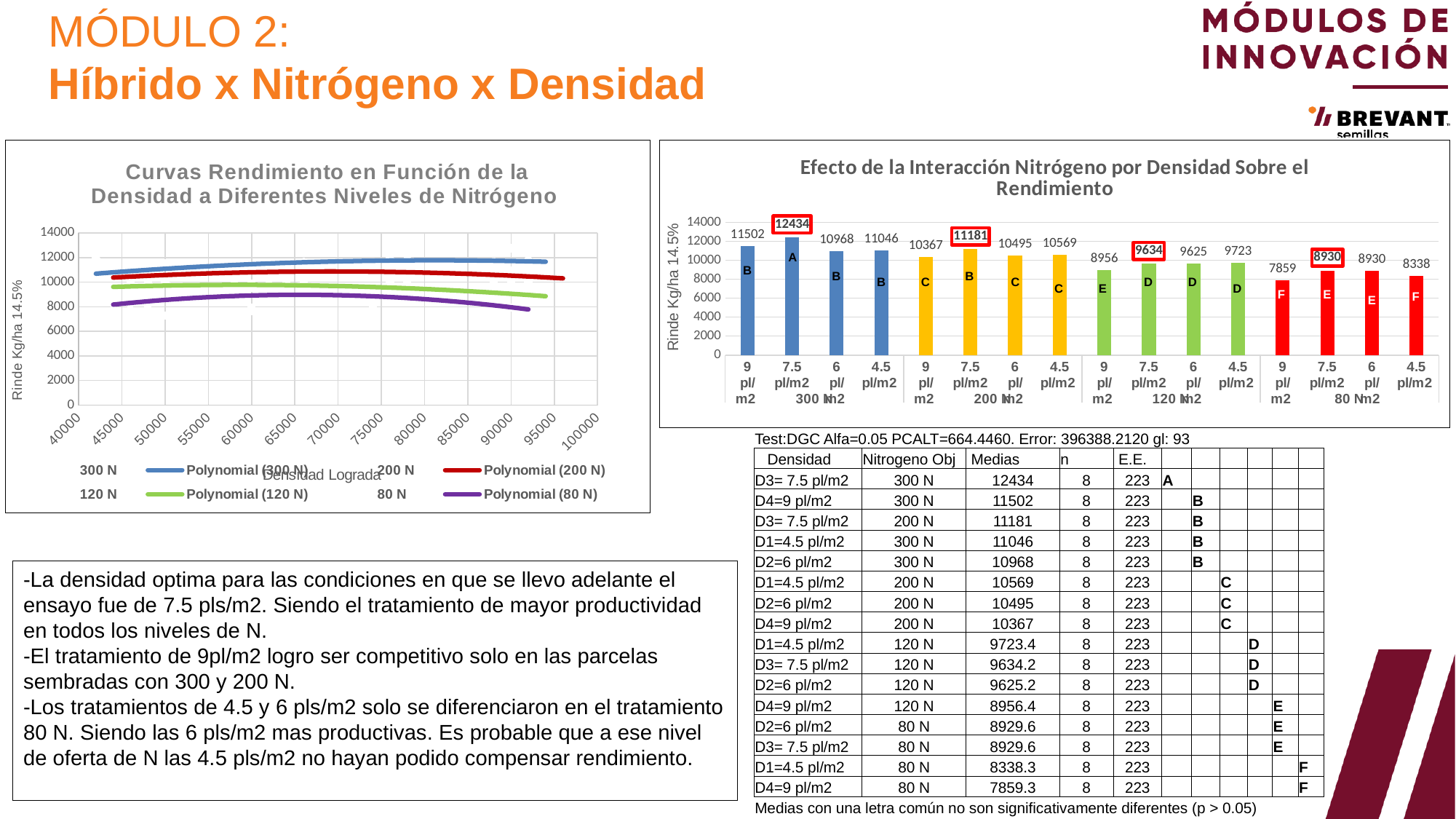
In the chart 'Efecto de la Interacción Nitrógeno por Densidad Sobre el Rendimiento', what is the difference between the 7.5 pl/m2 and 9 pl/m2 values at 300 N? 932 How many entries does the legend of the chart 'Curvas Rendimiento en Función de la Densidad a Diferentes Niveles de Nitrógeno' list? 8 In the chart 'Efecto de la Interacción Nitrógeno por Densidad Sobre el Rendimiento', what is the value for 9 pl/m2 at 80 N? 7859 In the chart 'Efecto de la Interacción Nitrógeno por Densidad Sobre el Rendimiento', which is larger at 200 N: 6 pl/m2 or 4.5 pl/m2? 4.5 pl/m2 What kind of chart is 'Efecto de la Interacción Nitrógeno por Densidad Sobre el Rendimiento'? Bar chart In the chart 'Efecto de la Interacción Nitrógeno por Densidad Sobre el Rendimiento', which bar has the highest value? 7.5 pl/m2 at 300 N In the chart 'Curvas Rendimiento en Función de la Densidad a Diferentes Niveles de Nitrógeno', is the 80 N curve at 60000 greater or less than 10000? less In the chart 'Efecto de la Interacción Nitrógeno por Densidad Sobre el Rendimiento', which bar has the lowest value? 9 pl/m2 at 80 N What kind of chart is 'Curvas Rendimiento en Función de la Densidad a Diferentes Niveles de Nitrógeno'? Line chart In the chart 'Efecto de la Interacción Nitrógeno por Densidad Sobre el Rendimiento', what is the value for 4.5 pl/m2 at 120 N? 9723 In the chart 'Efecto de la Interacción Nitrógeno por Densidad Sobre el Rendimiento', what is the value for 7.5 pl/m2 at 300 N? 12434 How many bars are plotted in the chart 'Efecto de la Interacción Nitrógeno por Densidad Sobre el Rendimiento'? 16